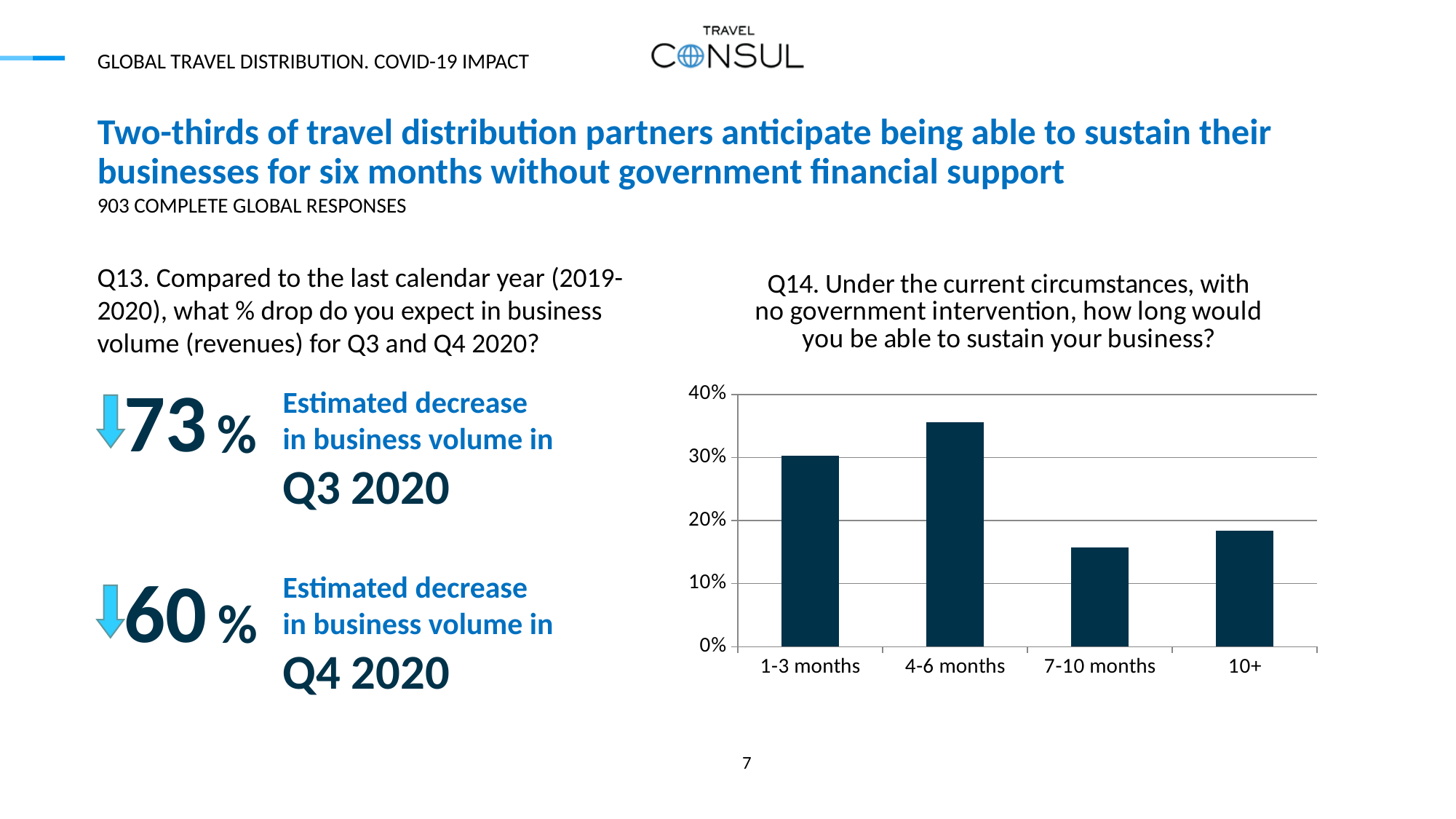
In the Q14 chart, which is larger: the value for 1-3 months or the value for 4-6 months? 4-6 months In the Q14 chart, is the value for 7-10 months greater or less than 20%? less In the Q14 chart, which category has the lowest value? 7-10 months In the Q14 chart, which is larger: the value for 7-10 months or the value for 10+? 10+ In the Q14 chart, is the value for 4-6 months greater or less than 30%? greater How many categories are shown on the x axis of the Q14 chart? 4 What is the title of the chart on the right of the slide? Q14. Under the current circumstances, with no government intervention, how long would you be able to sustain your business? In the Q14 chart, is the value for 10+ greater or less than 20%? less What kind of chart is shown for Q14? bar chart In the Q14 chart, which category has the highest value? 4-6 months What is the highest value shown on the y axis of the Q14 chart? 40%